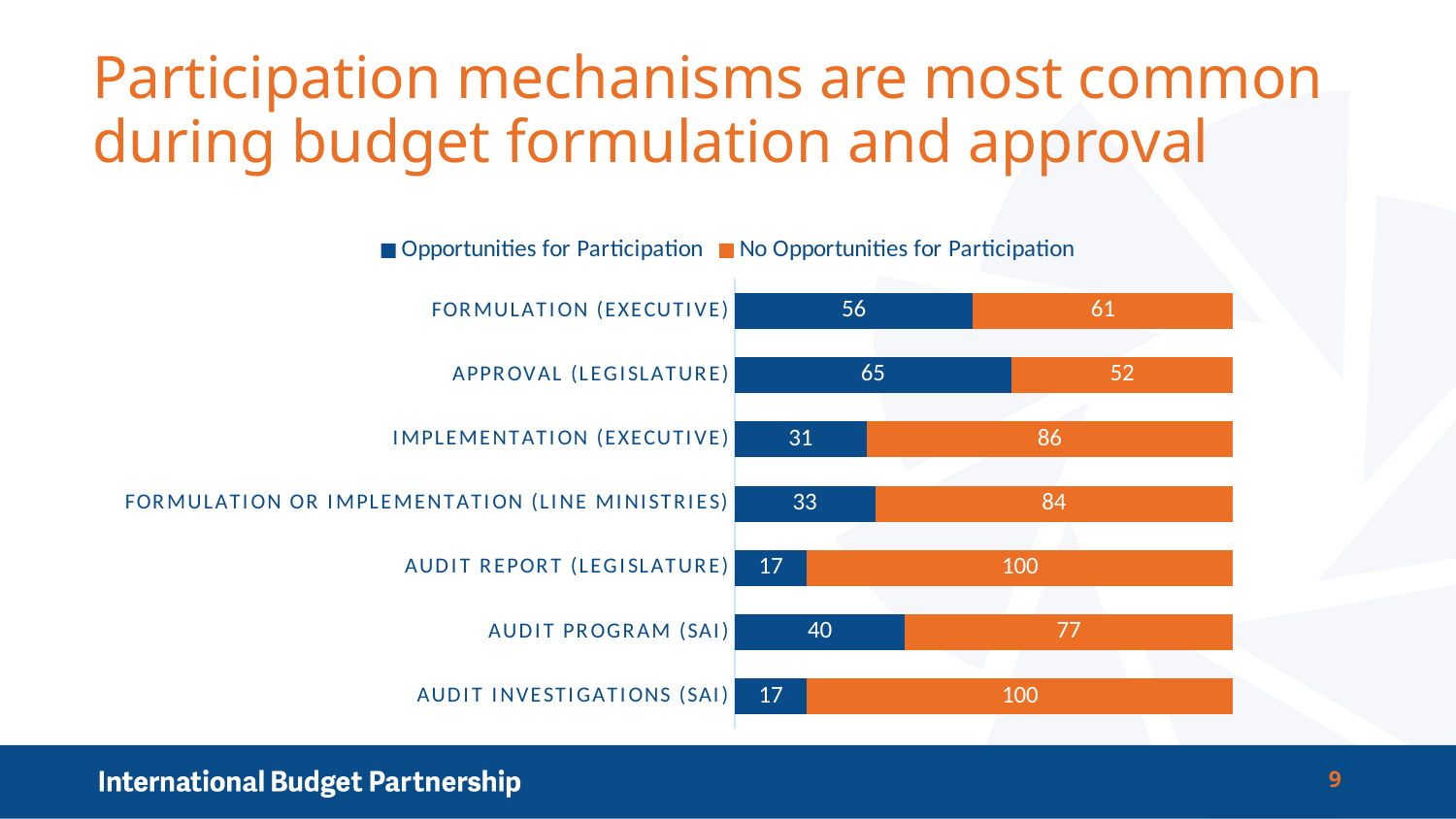
How many categories are shown on the chart? 7 What is the total of the stacked bar for Audit Report (Legislature)? 117 Which is larger for Formulation (Executive): Opportunities for Participation or No Opportunities for Participation? No Opportunities for Participation What kind of chart is shown on the slide? Stacked bar chart Which colour represents No Opportunities for Participation in the legend? Orange What is the value for Opportunities for Participation for Approval (Legislature)? 65 Which category has the lowest value for No Opportunities for Participation? Approval (Legislature) What is the difference between the No Opportunities for Participation value and the Opportunities for Participation value for Audit Program (SAI)? 37 What is the value for Opportunities for Participation for Formulation or Implementation (Line Ministries)? 33 What is the value for No Opportunities for Participation for Implementation (Executive)? 86 How many series does the legend list? 2 Which category has the highest value for Opportunities for Participation? Approval (Legislature)